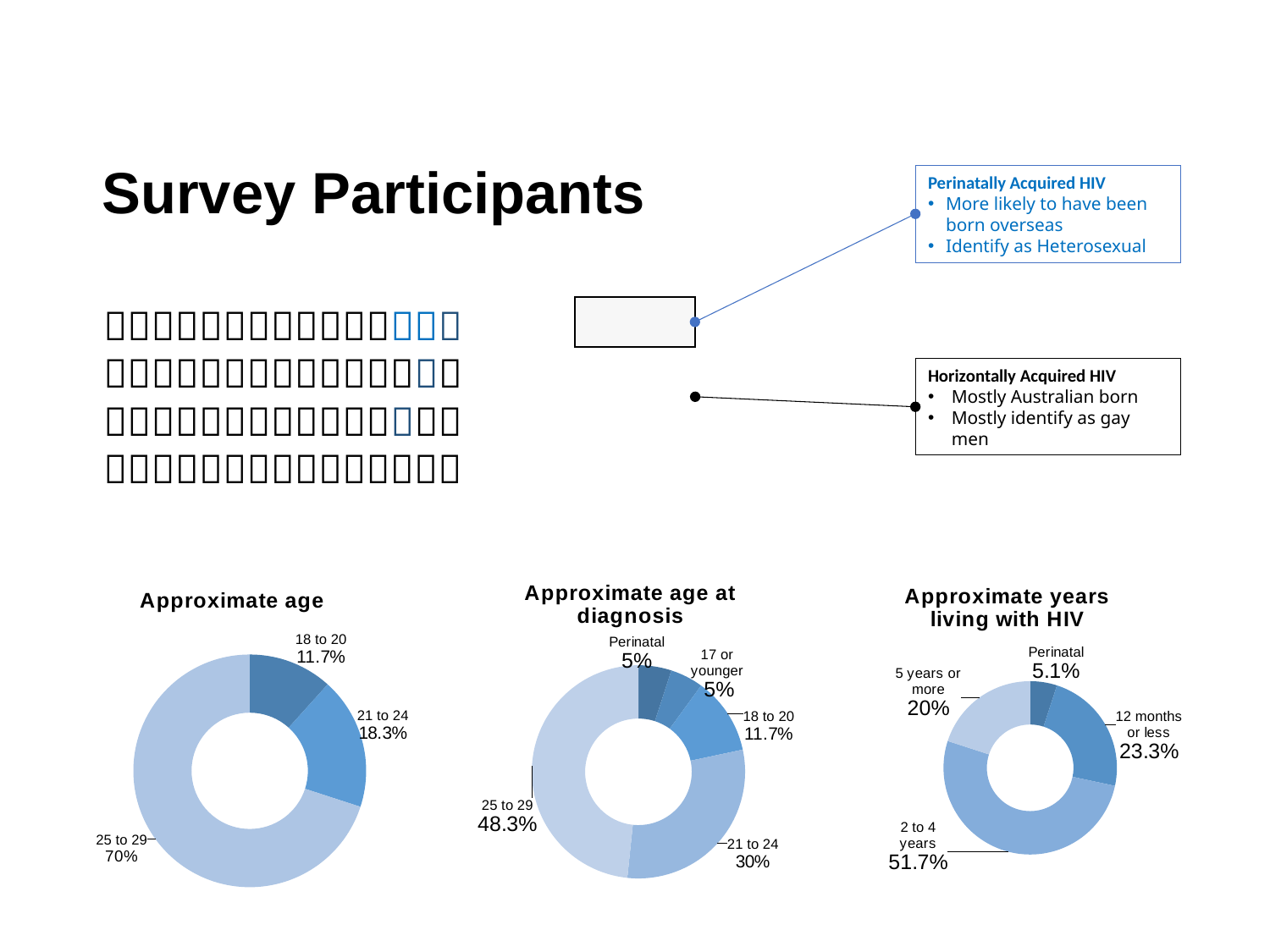
In the 'Approximate age at diagnosis' chart, what percentage of participants were diagnosed at age 21 to 24? 30% In the 'Approximate age at diagnosis' chart, what percentage of participants were diagnosed at age 25 to 29? 48.3% In the 'Approximate age at diagnosis' chart, how many categories are shown? 5 In the 'Approximate years living with HIV' chart, what is the difference between the '12 months or less' share and the 'Perinatal' share? 18.2% In the 'Approximate age at diagnosis' chart, which category has the largest share? 25 to 29 In the 'Approximate age' chart, how many age categories are shown? 3 What type of chart is used for 'Approximate years living with HIV'? Doughnut chart In the 'Approximate years living with HIV' chart, which is larger: '12 months or less' or '5 years or more'? 12 months or less In the 'Approximate age' chart, what percentage of participants are aged 21 to 24? 18.3% In the 'Approximate age' chart, what percentage of participants are aged 25 to 29? 70% In the 'Approximate age' chart, which age group has the smallest share? 18 to 20 In the 'Approximate years living with HIV' chart, what percentage of participants have been living with HIV for 2 to 4 years? 51.7%